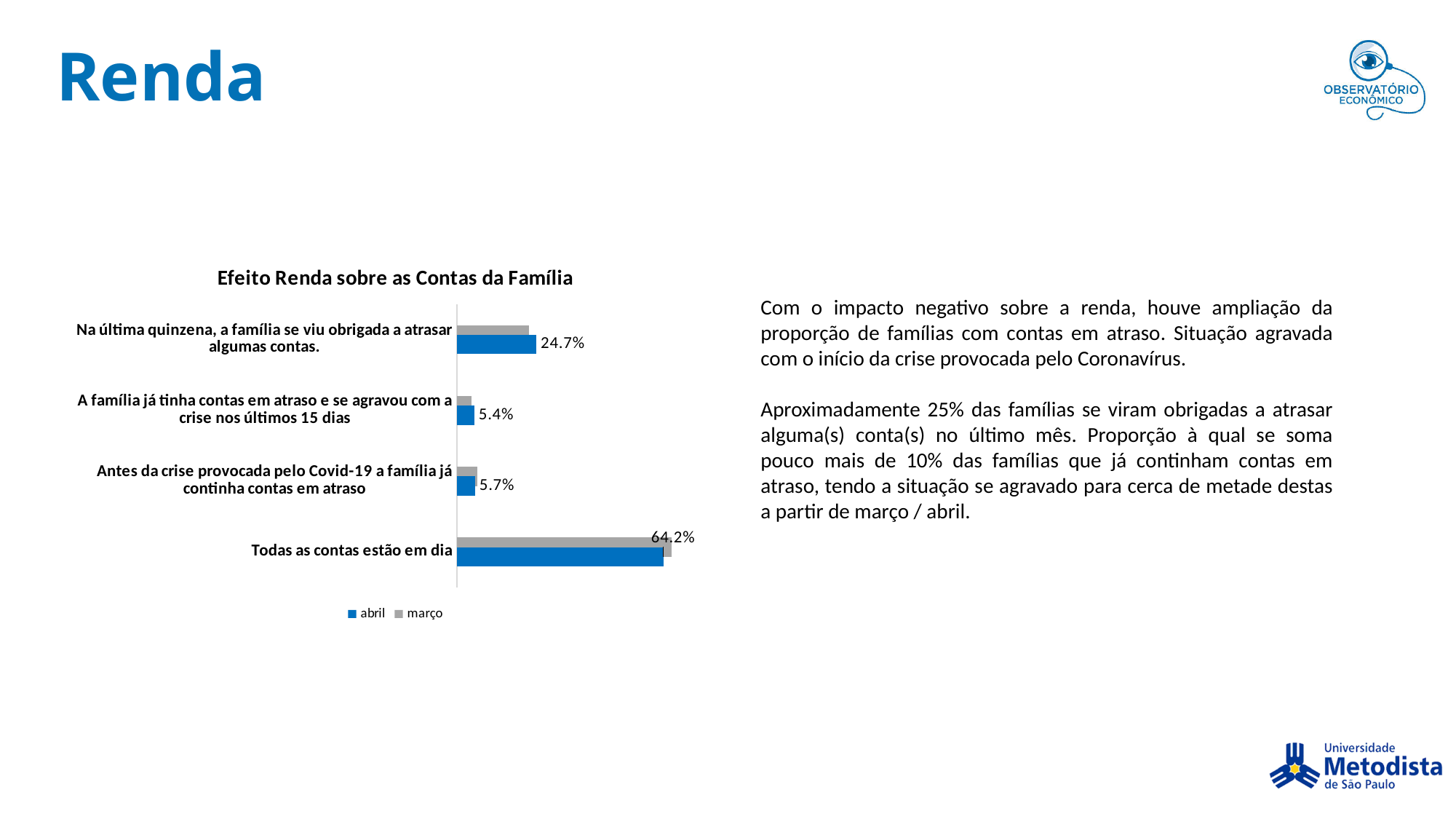
Which category has the highest values in the chart? Todas as contas estão em dia How many series does the legend list? 2 What is the difference between the abril values for "Na última quinzena, a família se viu obrigada a atrasar algumas contas." and "A família já tinha contas em atraso e se agravou com a crise nos últimos 15 dias"? 19.3 percentage points What is the abril value for "A família já tinha contas em atraso e se agravou com a crise nos últimos 15 dias"? 5.4% What is the title of the chart? Efeito Renda sobre as Contas da Família How many categories are shown in the chart? 4 Which is larger for abril: "Antes da crise provocada pelo Covid-19 a família já continha contas em atraso" or "A família já tinha contas em atraso e se agravou com a crise nos últimos 15 dias"? Antes da crise provocada pelo Covid-19 a família já continha contas em atraso What is the abril value for "Na última quinzena, a família se viu obrigada a atrasar algumas contas."? 24.7% What kind of chart is shown on the slide? Bar chart Which category has the lowest abril value? A família já tinha contas em atraso e se agravou com a crise nos últimos 15 dias What is the abril value for "Antes da crise provocada pelo Covid-19 a família já continha contas em atraso"? 5.7% For "Na última quinzena, a família se viu obrigada a atrasar algumas contas.", which series has the larger value, abril or março? abril